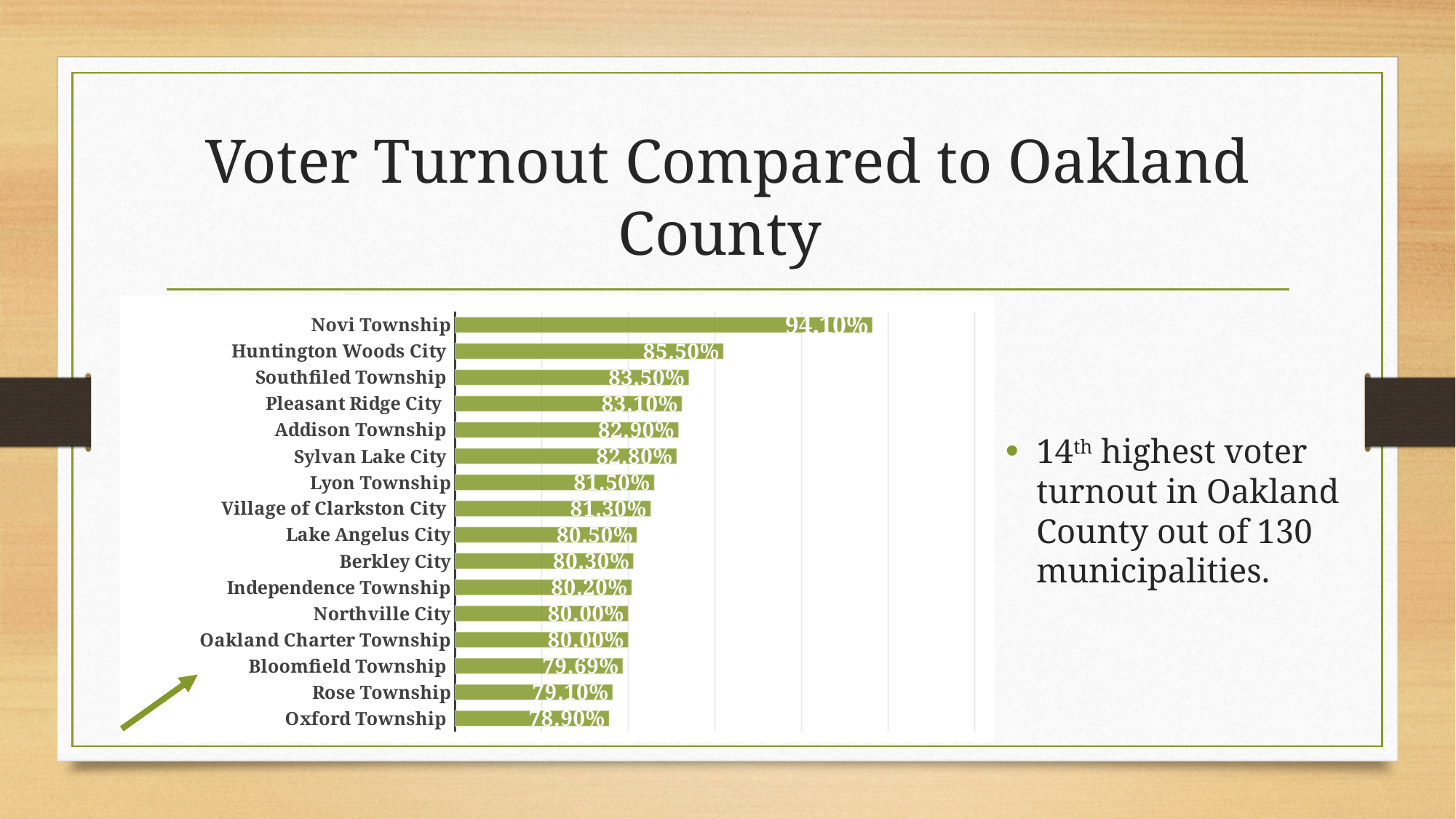
What is the voter turnout value shown for Novi Township? 94.10% What is the difference in voter turnout between Bloomfield Township and Oxford Township? 0.79% What is the voter turnout value shown for Village of Clarkston City? 81.30% Which municipality has the highest voter turnout in the chart? Novi Township What is the voter turnout value shown for Huntington Woods City? 85.50% What is the voter turnout value shown for Bloomfield Township? 79.69% Which municipality has the lowest voter turnout in the chart? Oxford Township How many municipalities are shown in the chart? 16 Which has a higher voter turnout, Lyon Township or Lake Angelus City? Lyon Township Do the voter turnout values increase or decrease going from the top bar to the bottom bar? Decrease What is the difference in voter turnout between Novi Township and Huntington Woods City? 8.60% What kind of chart is shown on the slide? Bar chart